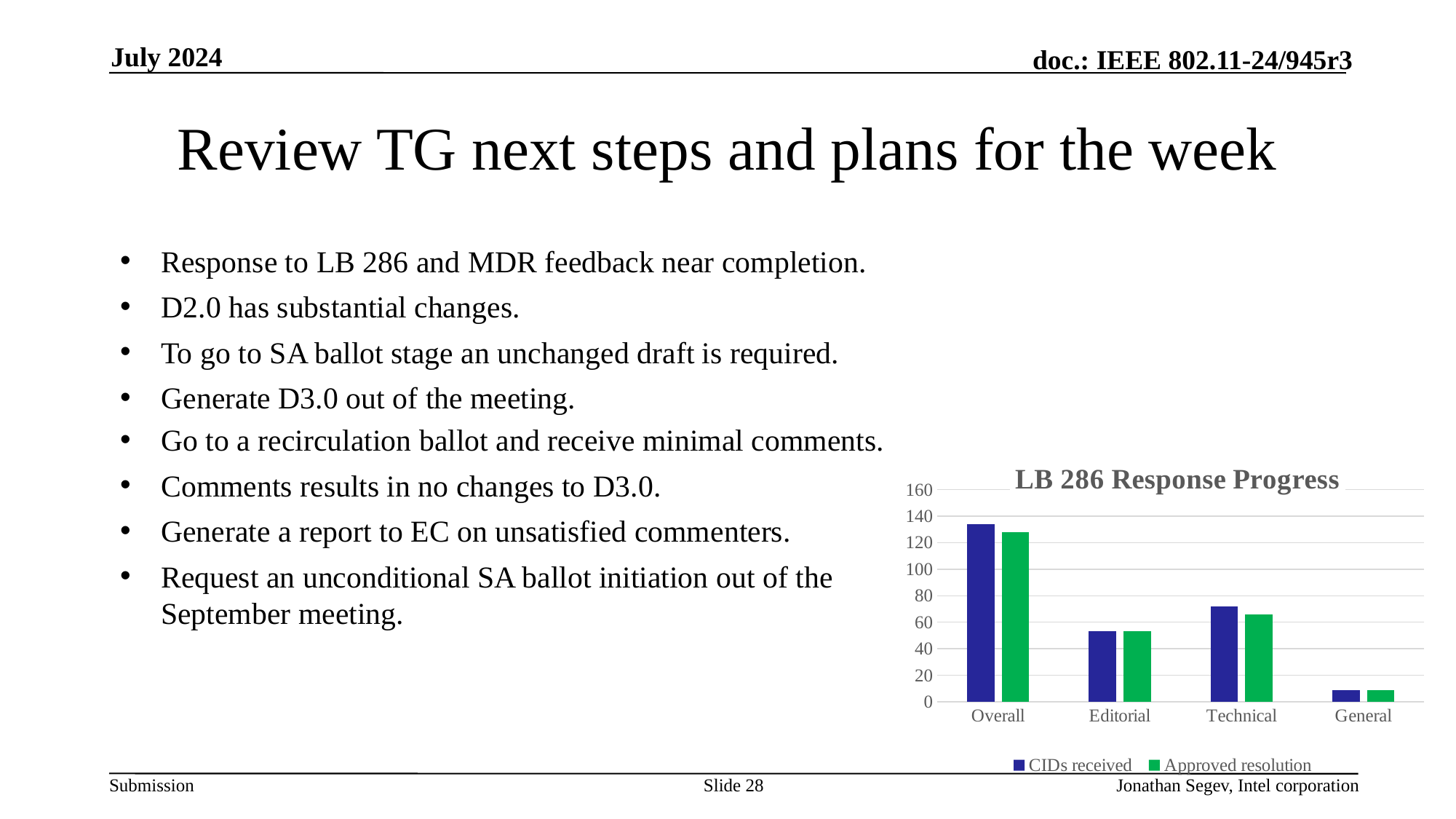
Which category has the highest value for CIDs received? Overall Is the value for CIDs received in the Overall category greater or less than 120? greater What kind of chart is shown on the slide? bar chart Which category has the lowest value for Approved resolution? General Is the value for CIDs received in the General category greater or less than 20? less Which is larger: CIDs received for Overall or CIDs received for Technical? Overall Is the value for Approved resolution in the Technical category greater or less than 80? less How many series does the chart's legend list? 2 Which series is shown in green in the chart? Approved resolution How many categories are shown on the x axis of the chart? 4 What is the title of the chart? LB 286 Response Progress